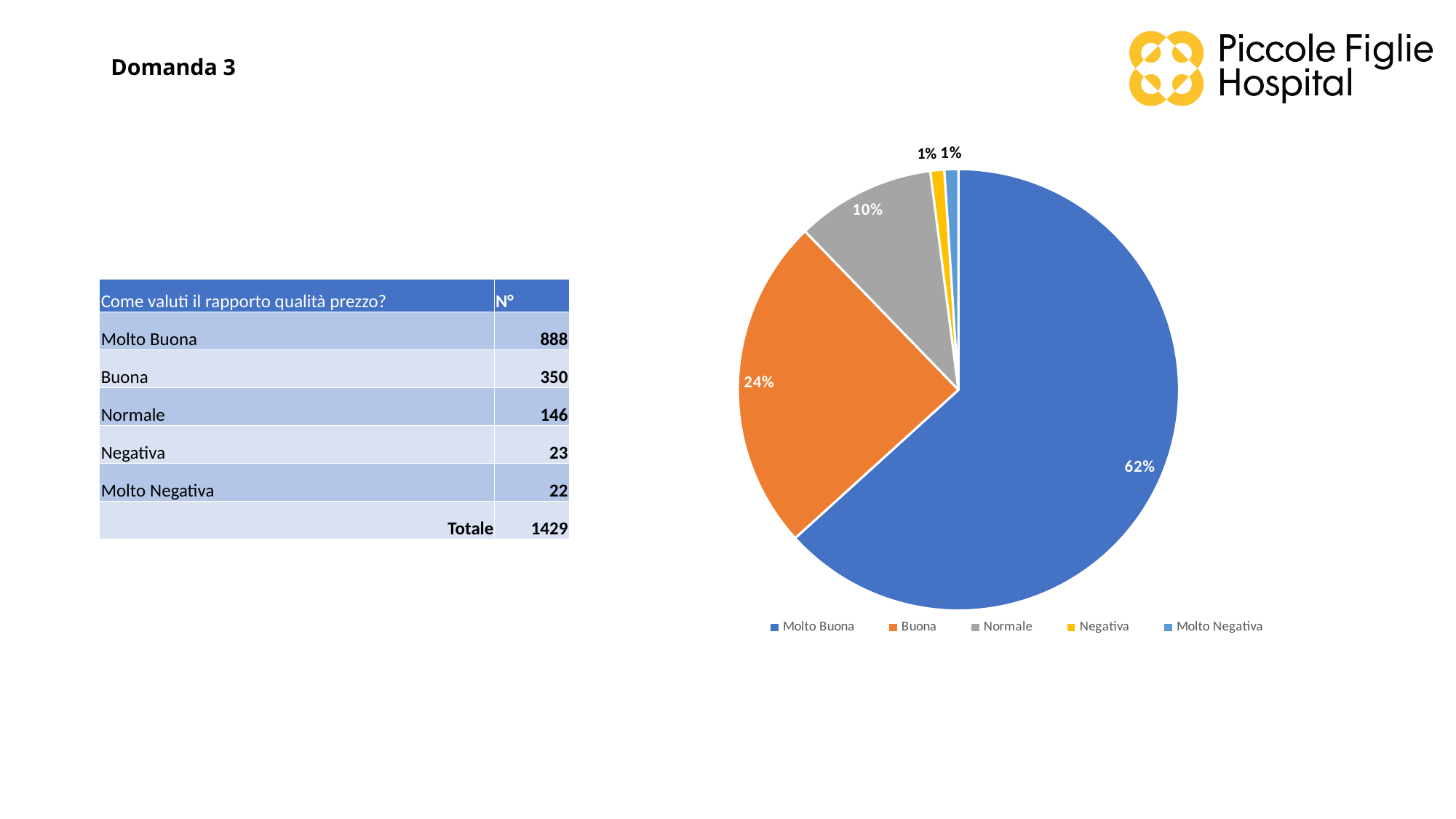
What percentage of the pie chart does the Normale slice represent? 10% Which slice is larger in the pie chart, Normale or Molto Buona? Molto Buona How many categories does the legend of the pie chart list? 5 What colour is the Negativa slice in the pie chart? yellow What colour is the Molto Buona slice in the pie chart? blue What is the difference in percentage points between the Molto Buona slice and the Buona slice? 38% How many slices does the pie chart have? 5 What kind of chart is shown on the slide? pie chart What percentage of the pie chart does the Molto Buona slice represent? 62% Which slice is larger in the pie chart, Buona or Normale? Buona Which category has the largest slice in the pie chart? Molto Buona What percentage of the pie chart does the Buona slice represent? 24%